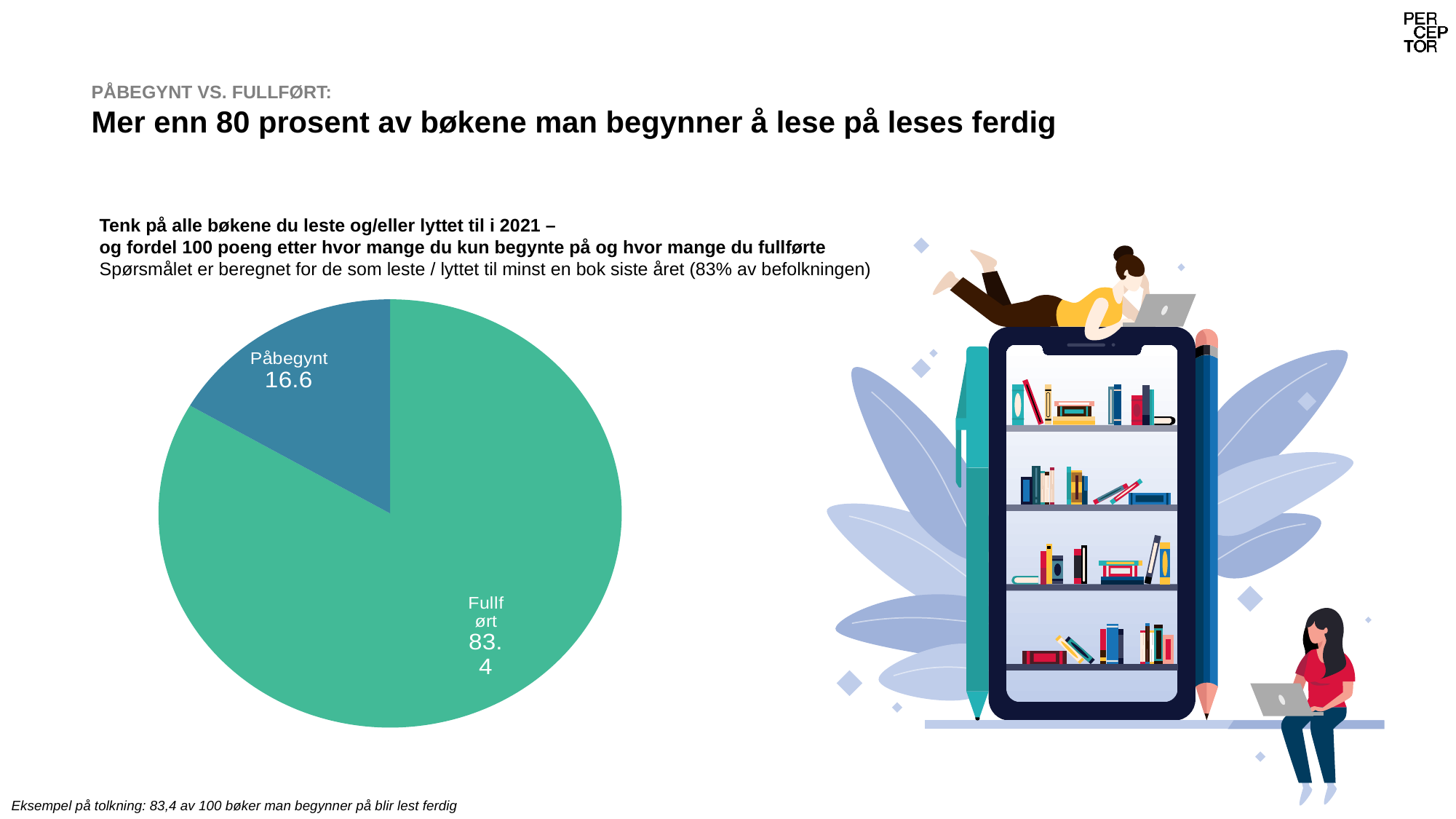
What is the total of the two slices in the pie chart? 100 Which is larger, Påbegynt or Fullført? Fullført Which slice is the smallest? Påbegynt How many slices does the pie chart have? 2 What colour is the Påbegynt slice? blue What is the value for Fullført? 83.4 What kind of chart is shown on the slide? pie chart Which slice is the largest? Fullført What is the difference between the values for Fullført and Påbegynt? 66.8 What colour is the Fullført slice? green What is the value for Påbegynt? 16.6 What share of the pie does Fullført represent? 83.4%